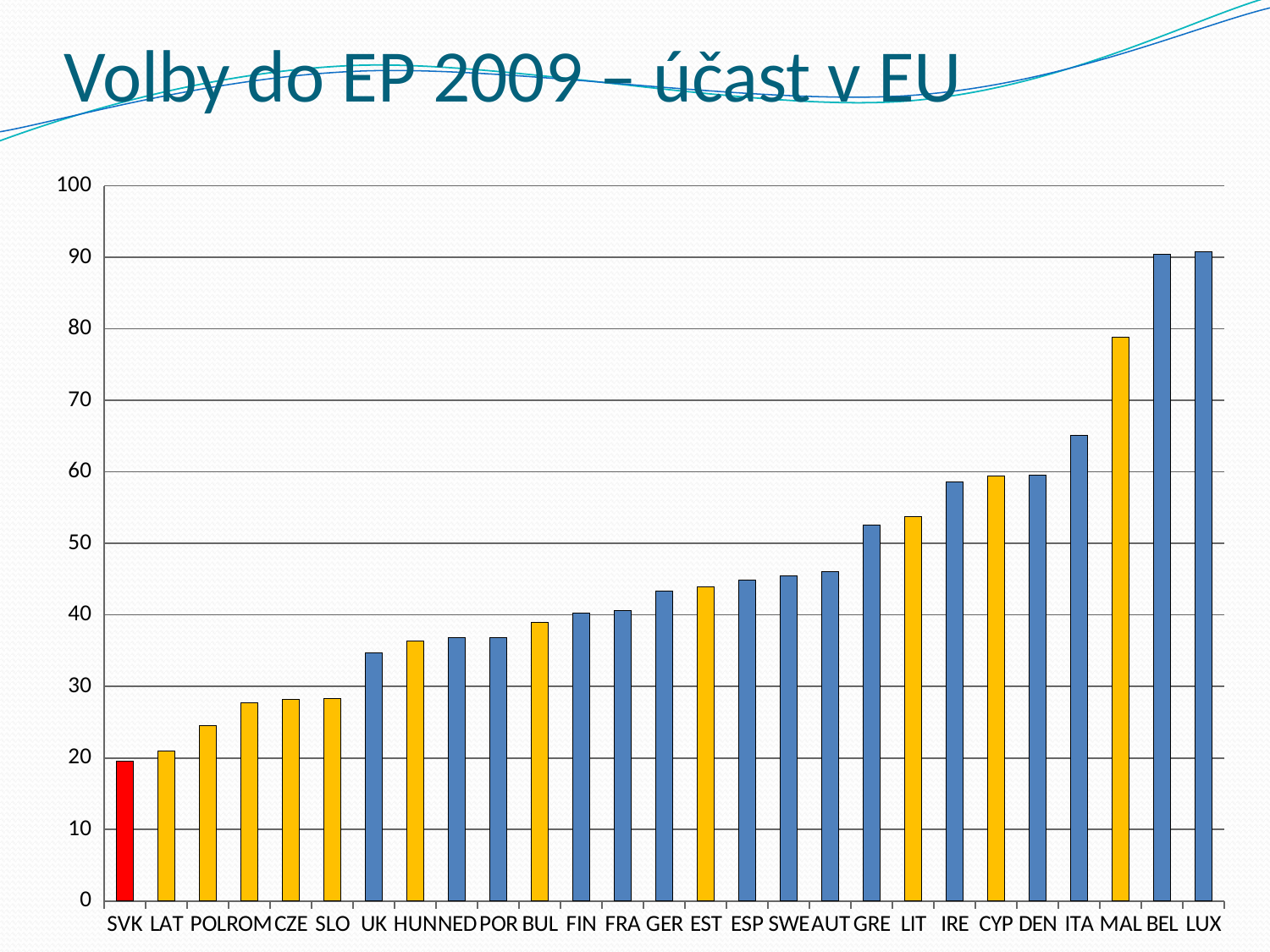
Do the values rise or fall from left to right along the x axis? rise Is the value for EST greater or less than 50? less Which country has the lowest value in the chart? SVK Is the value for POL greater or less than 30? less What colour is the bar for SVK? red Is the value for ITA greater or less than 60? greater Which has the larger value, MAL or ITA? MAL How many countries are shown on the x axis of the chart? 27 Which has the larger value, SVK or LAT? LAT What kind of chart is shown on the slide? bar chart